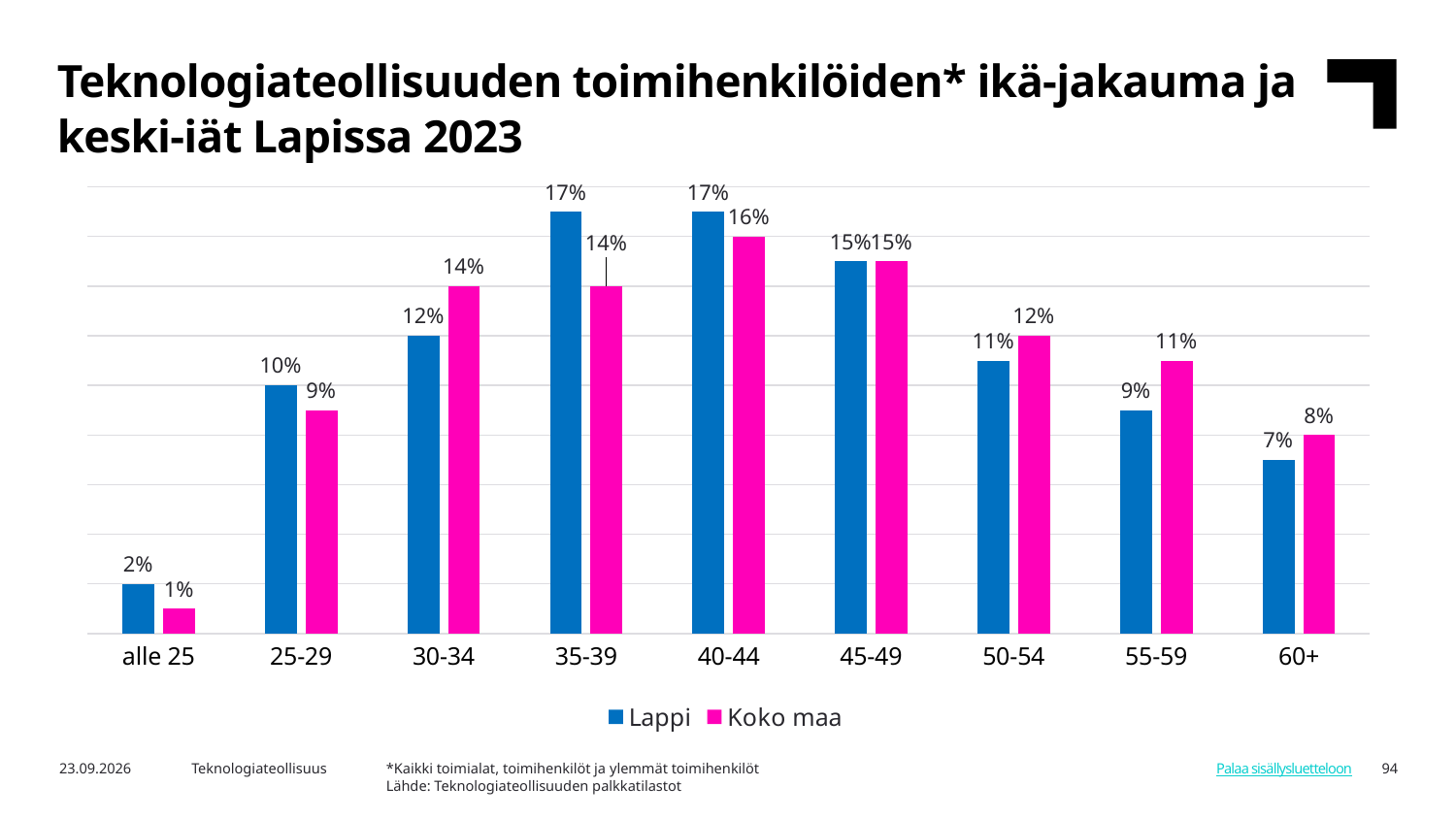
Which series is shown in pink? Koko maa In the 50-54 age group, which series has the larger value, Lappi or Koko maa? Koko maa Which age group has the highest value for Koko maa? 40-44 How many series does the legend list? 2 What is the value for Koko maa in the 55-59 age group? 11% How many age groups are shown on the x axis? 9 What kind of chart is shown on the slide? Bar chart What is the difference between the Lappi and Koko maa values in the 35-39 age group? 3 percentage points What is the value for Lappi in the 60+ age group? 7% What is the value for Koko maa in the 35-39 age group? 14% Which age group has the lowest value for Lappi? alle 25 What is the value for Lappi in the 30-34 age group? 12%